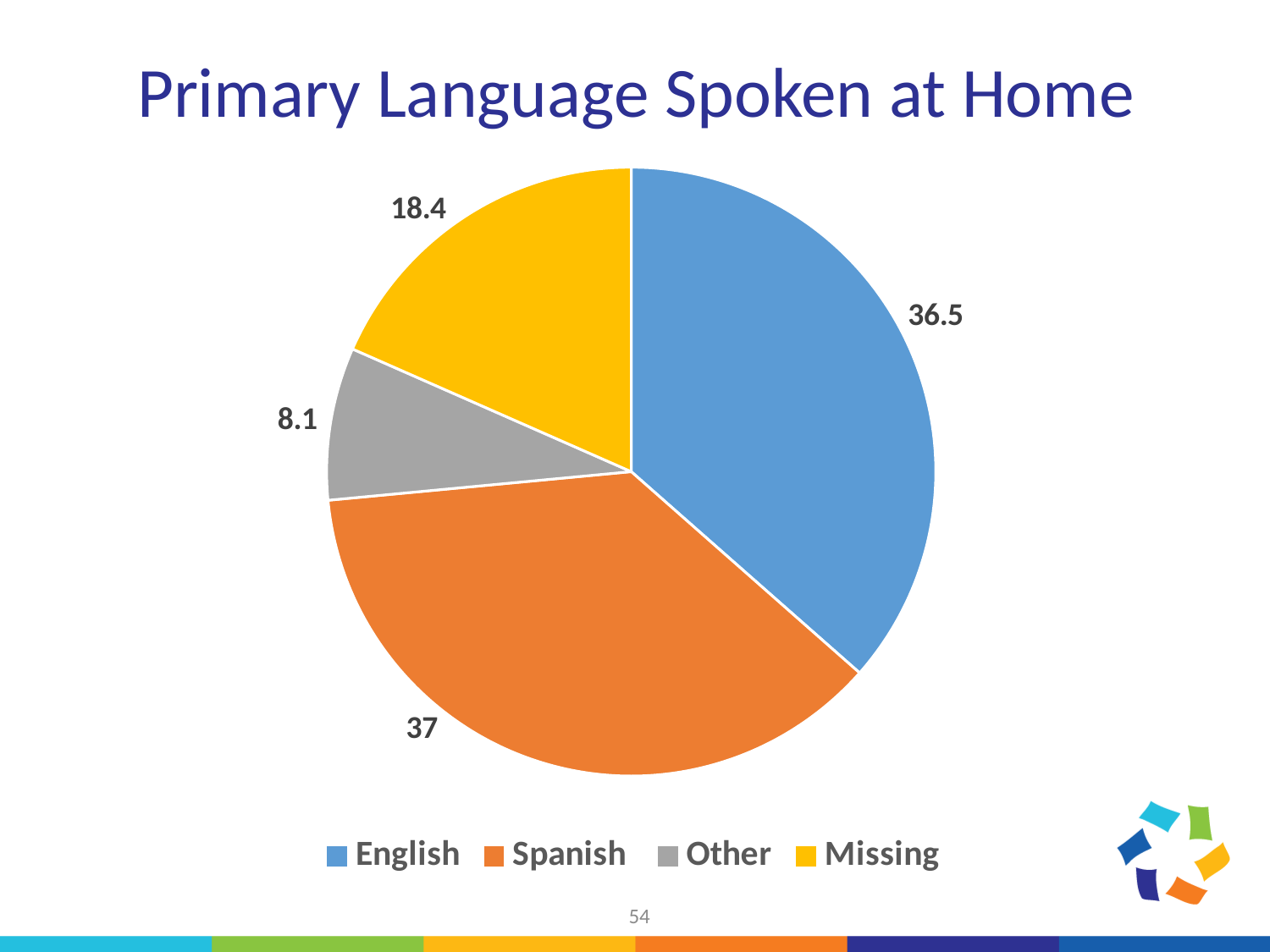
How many categories are shown in the pie chart? 4 What kind of chart is shown on the slide? Pie chart What is the difference between the values for Missing and Other? 10.3 Which category has the smallest slice of the pie? Other What is the value shown for Missing? 18.4 What is the value shown for Other? 8.1 Which is larger, the value for English or the value for Missing? English What is the value shown for Spanish? 37 What is the value shown for English? 36.5 What is the title of the chart? Primary Language Spoken at Home Which is larger, the value for Missing or the value for Other? Missing What is the difference between the values for English and Missing? 18.1